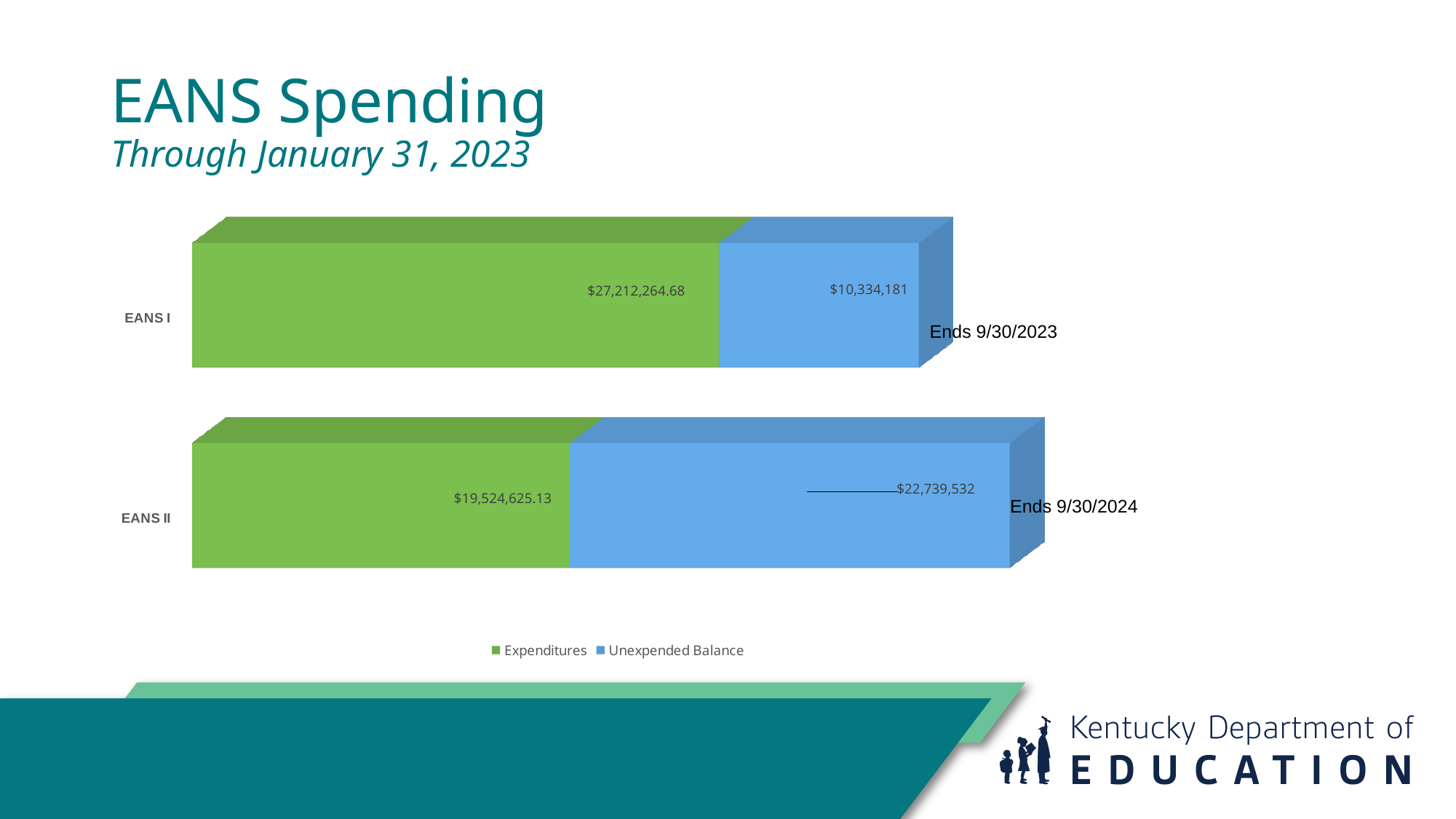
How many categories are plotted in the chart? 2 Which category has the higher Expenditures, EANS I or EANS II? EANS I Which category has the larger Unexpended Balance? EANS II What is the difference between the Unexpended Balance of EANS II and EANS I? $12,405,351 What is the total of the EANS I bar (Expenditures plus Unexpended Balance)? $37,546,445.68 What is the Unexpended Balance for EANS I? $10,334,181 What is the Expenditures value for EANS I? $27,212,264.68 What is the Expenditures value for EANS II? $19,524,625.13 Which colour represents Unexpended Balance in the chart? Blue What kind of chart is shown on the slide? Stacked bar chart What is the Unexpended Balance for EANS II? $22,739,532 How many series does the legend list? 2